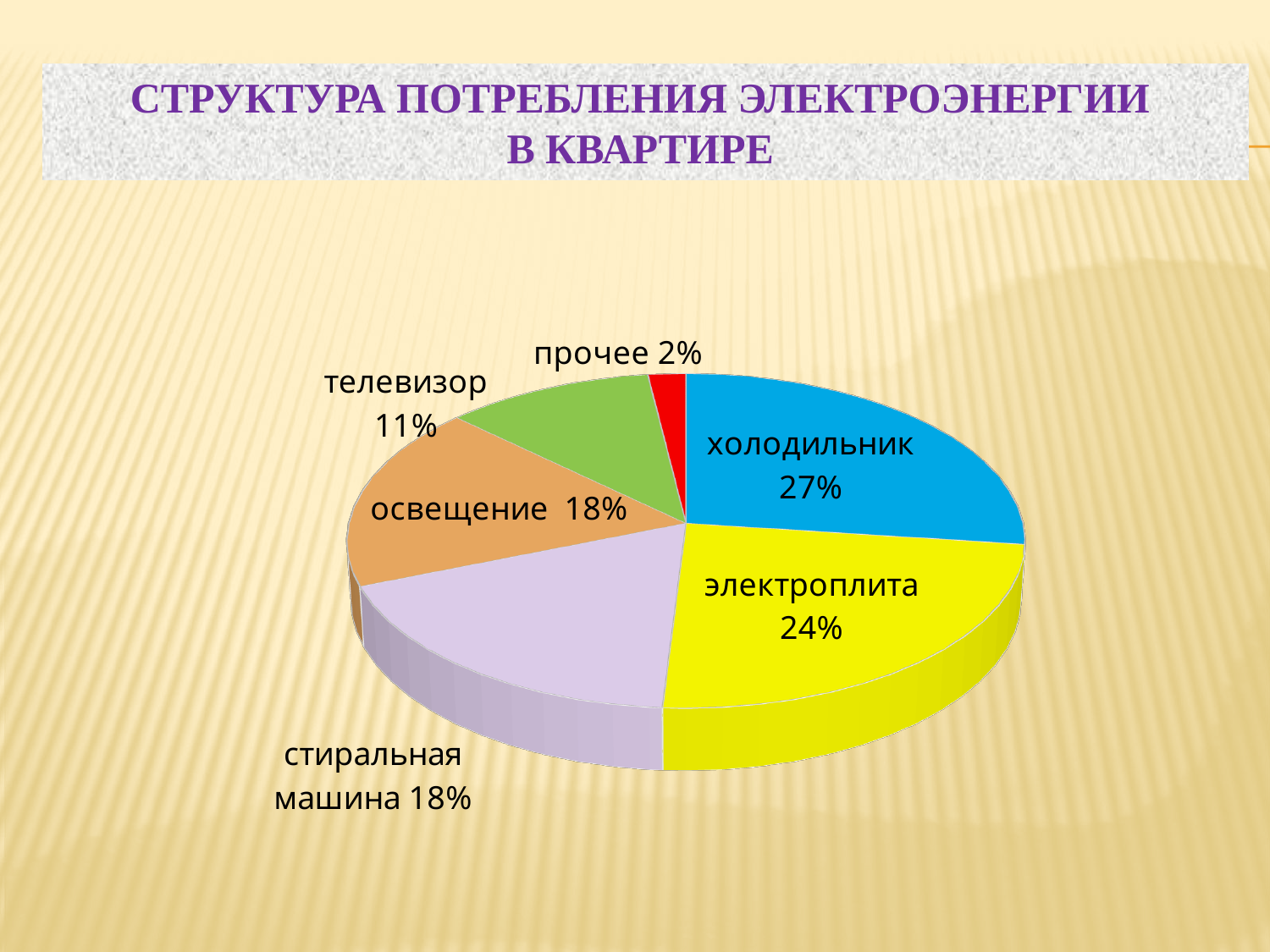
What kind of chart is shown on the slide? pie chart What share of electricity consumption does телевизор account for? 11% Which category has the largest share of electricity consumption? холодильник Which has a larger share, освещение or телевизор? освещение What share of electricity consumption does холодильник account for? 27% What is the difference in percentage points between холодильник and электроплита? 3 What share of electricity consumption does прочее account for? 2% What share of electricity consumption does электроплита account for? 24% Which category has the smallest share of electricity consumption? прочее How many categories are shown in the pie chart? 6 What share of electricity consumption does стиральная машина account for? 18% What is the title of the slide containing the chart? СТРУКТУРА ПОТРЕБЛЕНИЯ ЭЛЕКТРОЭНЕРГИИ В КВАРТИРЕ